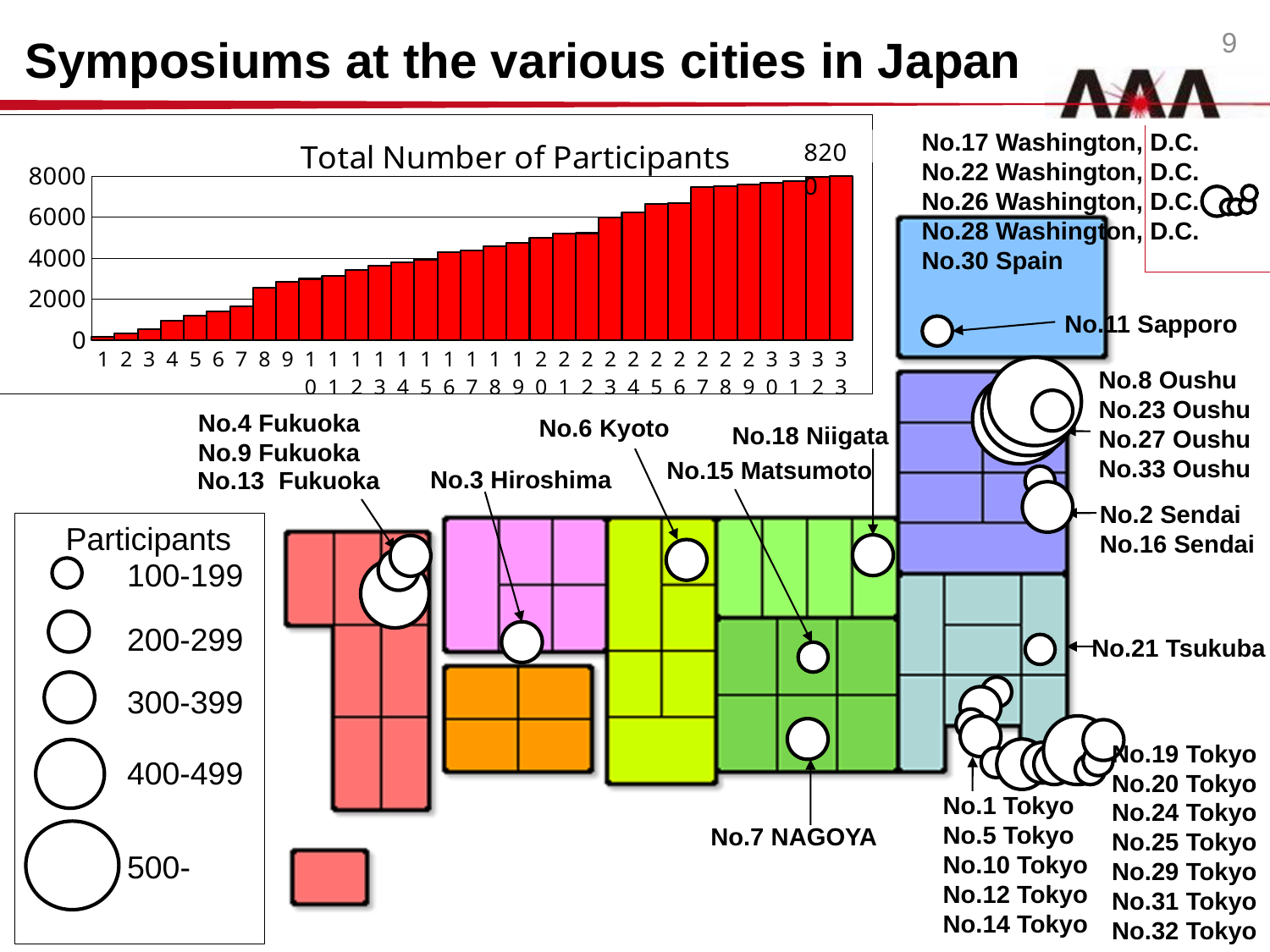
What colour are the bars in the 'Total Number of Participants' chart? red Do the values in the 'Total Number of Participants' chart rise or fall from left to right along the x axis? rise In the 'Total Number of Participants' chart, is the value for category 10 greater or less than 2000? greater In the 'Total Number of Participants' chart, is the value for category 25 greater or less than 6000? greater What is the title of the chart on the slide? Total Number of Participants In the 'Total Number of Participants' chart, is the value for category 30 greater or less than 6000? greater Which category has the highest value in the 'Total Number of Participants' chart? 33 Which category has the lowest value in the 'Total Number of Participants' chart? 1 What kind of chart is the 'Total Number of Participants' chart? bar chart How many bars are plotted in the 'Total Number of Participants' chart? 33 In the 'Total Number of Participants' chart, which is larger, the value for category 20 or the value for category 10? 20